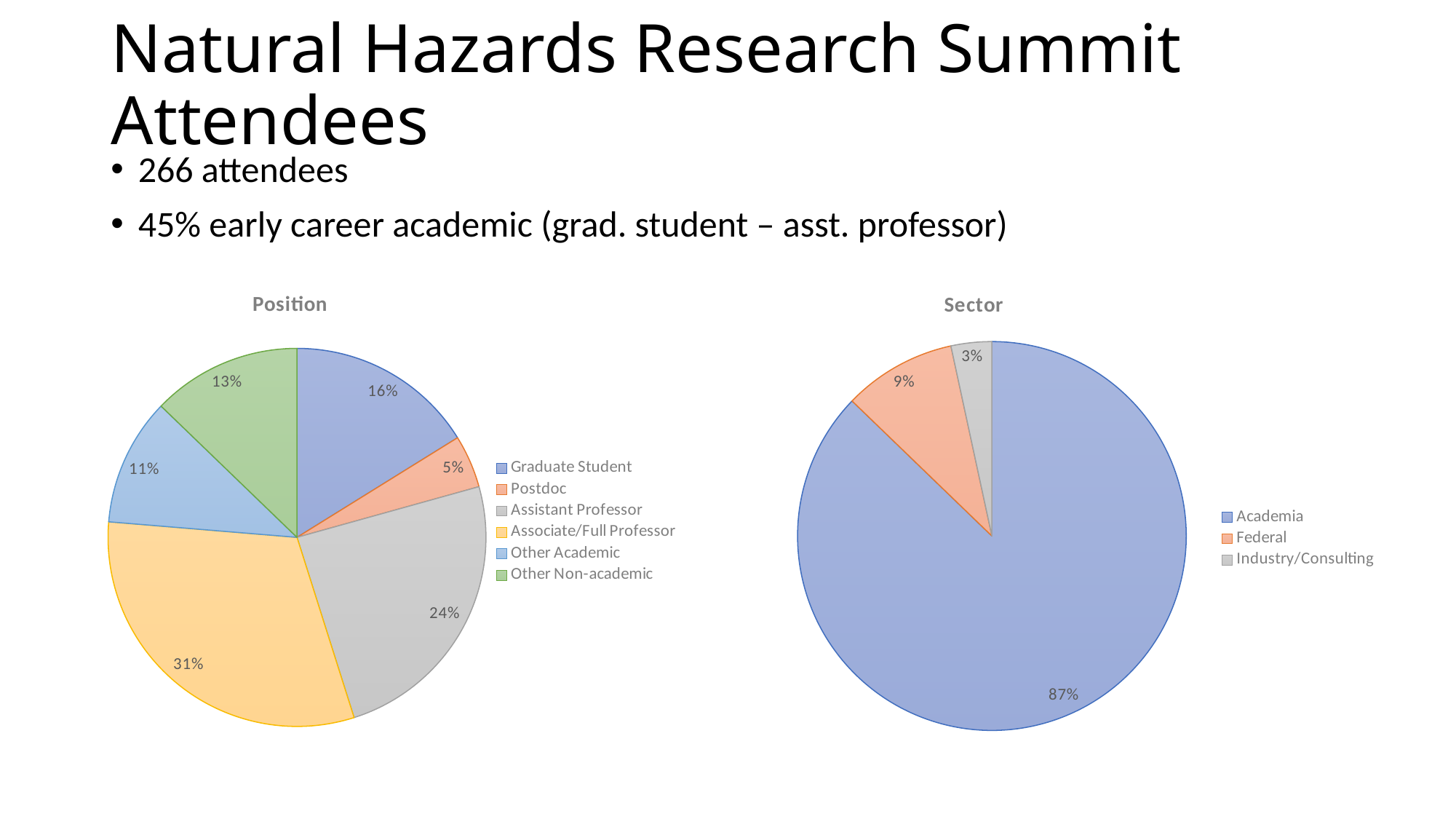
In the Position chart, which is larger: Other Non-academic or Other Academic? Other Non-academic In the Position chart, what share of attendees are Associate/Full Professors? 31% What type of chart is the Sector chart? Pie chart In the Position chart, which position has the largest share? Associate/Full Professor How many categories does the Position chart's legend list? 6 In the Position chart, what share of attendees are Graduate Students? 16% In the Sector chart, what share of attendees are from Academia? 87% In the Position chart, which position has the smallest share? Postdoc In the Sector chart, what is the difference between the Federal share and the Industry/Consulting share? 6% In the Sector chart, what share of attendees are from Industry/Consulting? 3% In the Position chart, what is the difference between the Assistant Professor share and the Other Academic share? 13% In the Position chart, what share of attendees are Postdocs? 5%